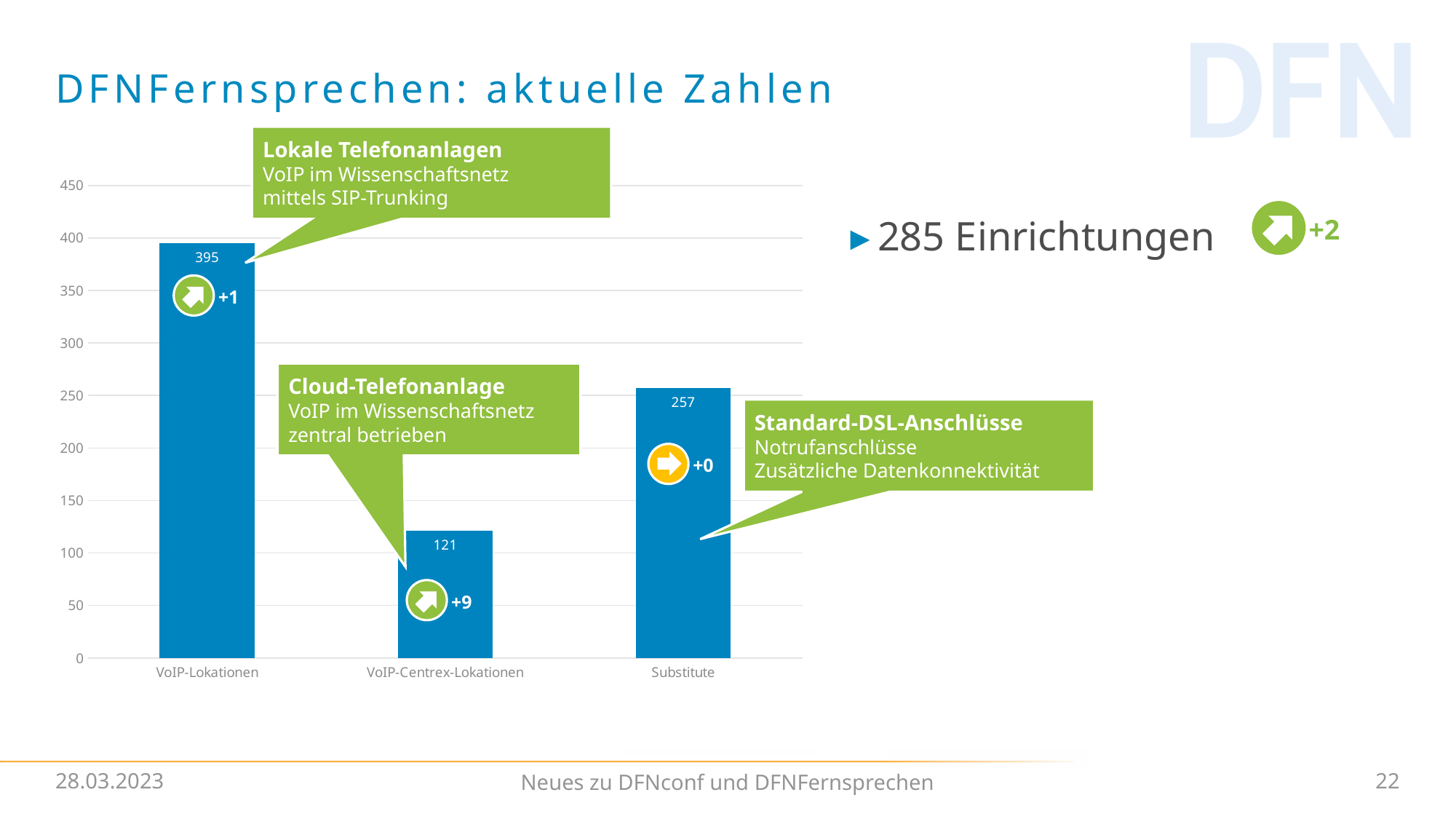
What is the title of the slide containing the chart? DFNFernsprechen: aktuelle Zahlen Which is larger, the value for Substitute or the value for VoIP-Centrex-Lokationen? Substitute What is the difference between the values for VoIP-Lokationen and Substitute? 138 How many categories are shown on the x axis? 3 What is the value for Substitute? 257 What is the value for VoIP-Lokationen? 395 What is the difference between the values for Substitute and VoIP-Centrex-Lokationen? 136 What kind of chart is shown on the slide? bar chart Which category has the highest value? VoIP-Lokationen What is the value for VoIP-Centrex-Lokationen? 121 Is the value for Substitute greater or less than 250? greater Which category has the lowest value? VoIP-Centrex-Lokationen